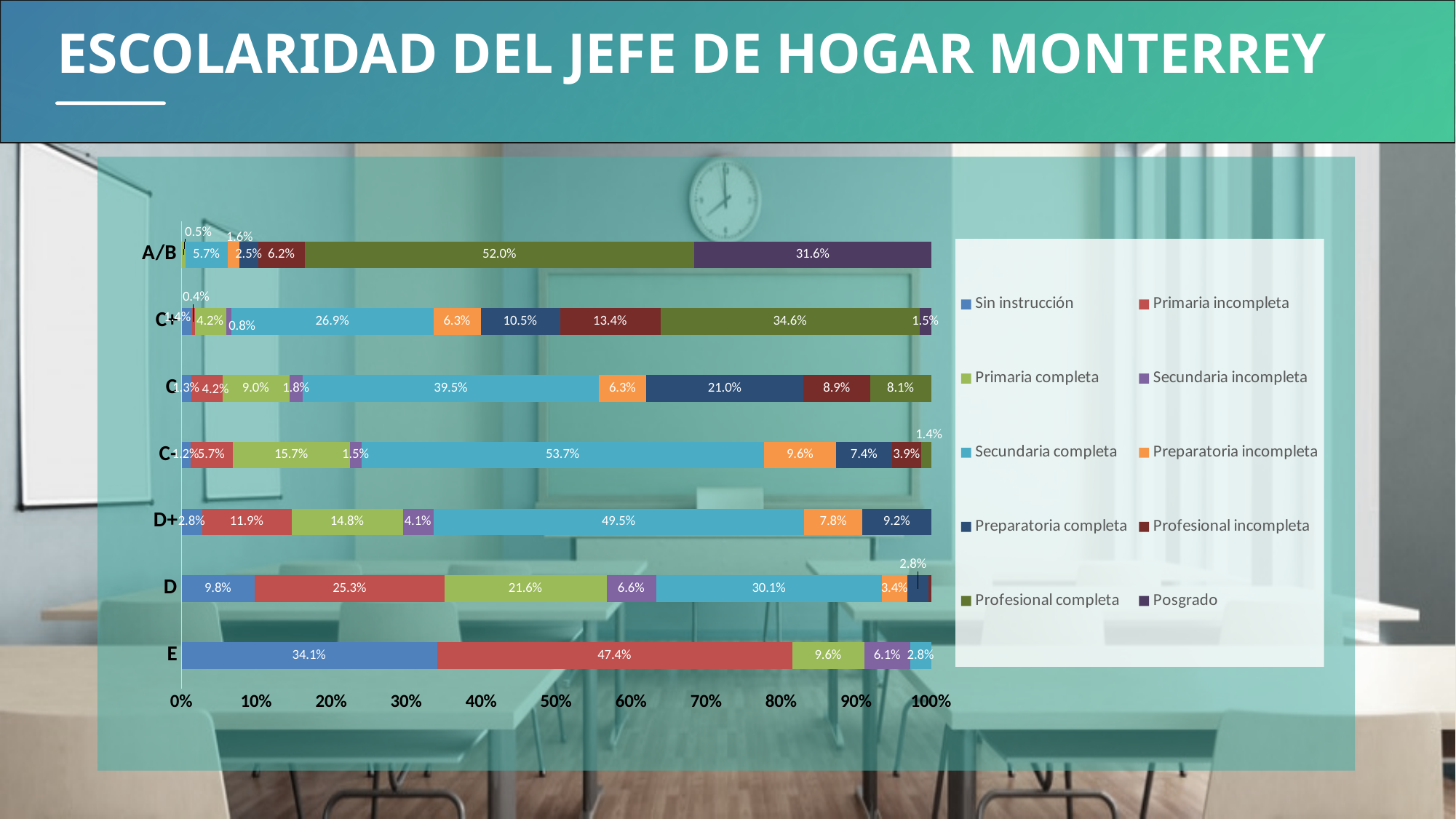
How many socioeconomic categories are plotted on the y axis? 7 What is the Posgrado value for the A/B category? 31.6% What is the Sin instrucción value for the E category? 34.1% Which is larger: the Secundaria completa value for D+ or the Secundaria completa value for D? D+ What is the Secundaria completa value for the C- category? 53.7% What is the difference between the Primaria incompleta value for E (47.4%) and the Sin instrucción value for E (34.1%)? 13.3% What is the Preparatoria completa value for the C category? 21.0% What is the Primaria incompleta value for the D category? 25.3% How many series does the legend list? 10 Which education level has the largest share in the E category? Primaria incompleta What is the Profesional completa value for the A/B category? 52.0% What kind of chart is shown on the slide? Stacked bar chart